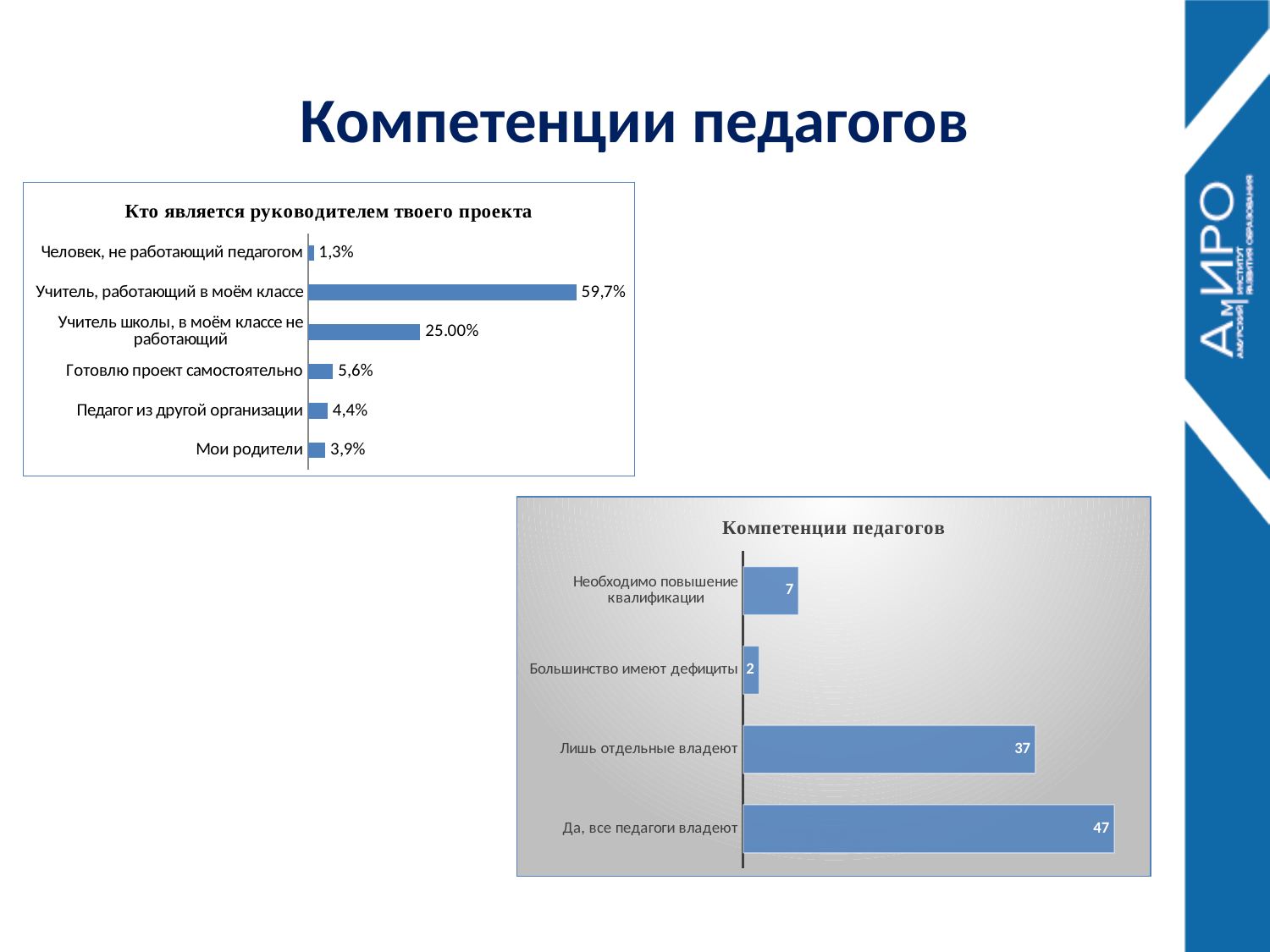
In the chart titled "Кто является руководителем твоего проекта", how many categories are shown? 6 In the chart titled "Компетенции педагогов", what is the value for "Большинство имеют дефициты"? 2 In the chart titled "Кто является руководителем твоего проекта", which is larger: "Готовлю проект самостоятельно" or "Педагог из другой организации"? Готовлю проект самостоятельно In the chart titled "Кто является руководителем твоего проекта", which category has the lowest value? Человек, не работающий педагогом In the chart titled "Компетенции педагогов", what is the value for "Лишь отдельные владеют"? 37 In the chart titled "Кто является руководителем твоего проекта", what is the value for "Мои родители"? 3,9% In the chart titled "Кто является руководителем твоего проекта", which category has the highest value? Учитель, работающий в моём классе In the chart titled "Компетенции педагогов", how many categories are shown? 4 In the chart titled "Кто является руководителем твоего проекта", what is the value for "Учитель, работающий в моём классе"? 59,7% What type of chart is the chart titled "Компетенции педагогов"? Bar chart In the chart titled "Компетенции педагогов", which category has the highest value? Да, все педагоги владеют In the chart titled "Компетенции педагогов", what is the difference between "Да, все педагоги владеют" and "Лишь отдельные владеют"? 10